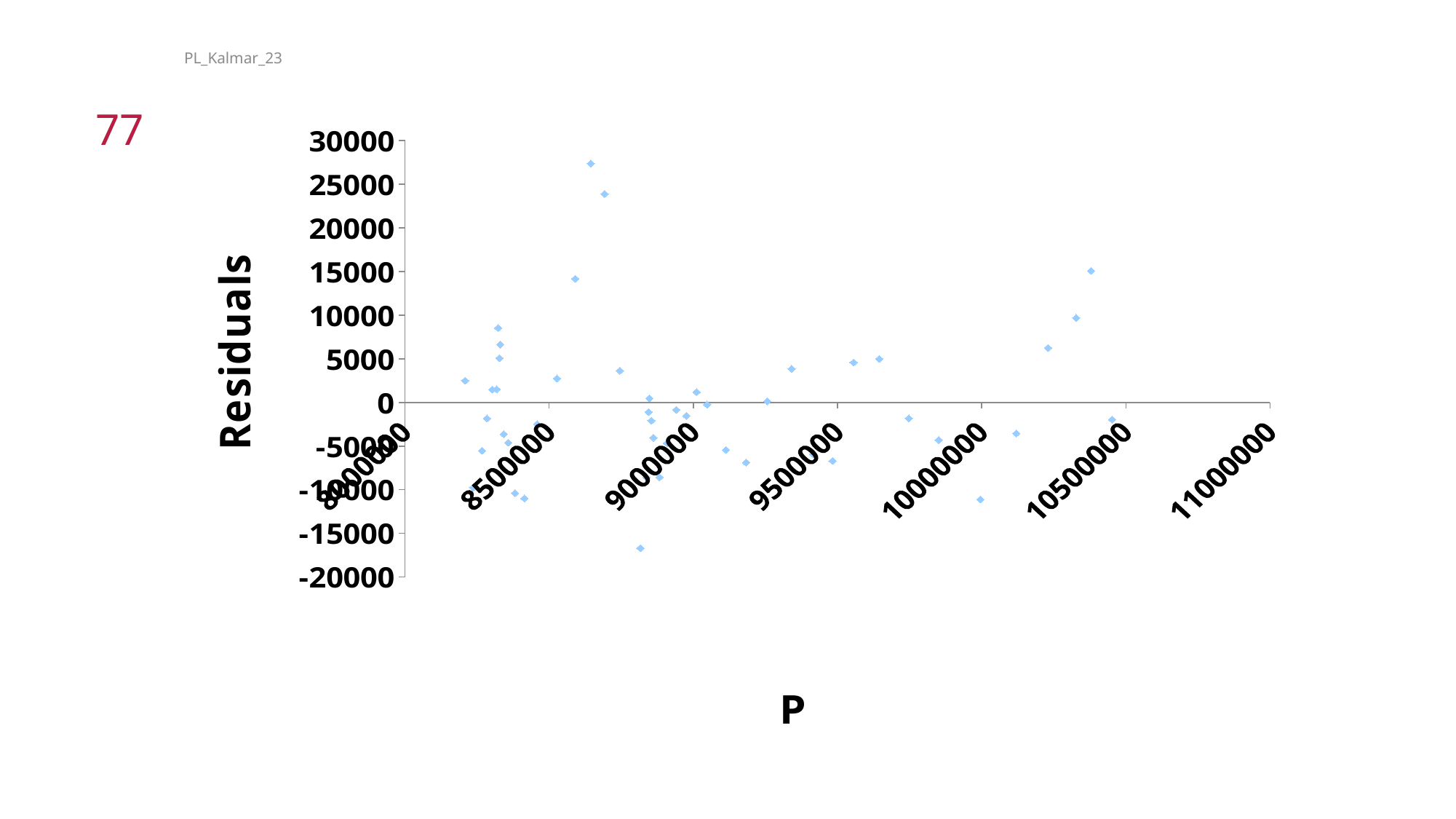
Are there any points plotted with P greater than 10500000? no What kind of chart is shown on the slide? scatter plot Is the lowest residual plotted greater or less than -15000? less Which is larger in absolute value: the highest positive residual or the most negative residual? the highest positive residual Is the highest residual plotted greater or less than 30000? less What is the label of the vertical axis? Residuals What is the label of the horizontal axis? P